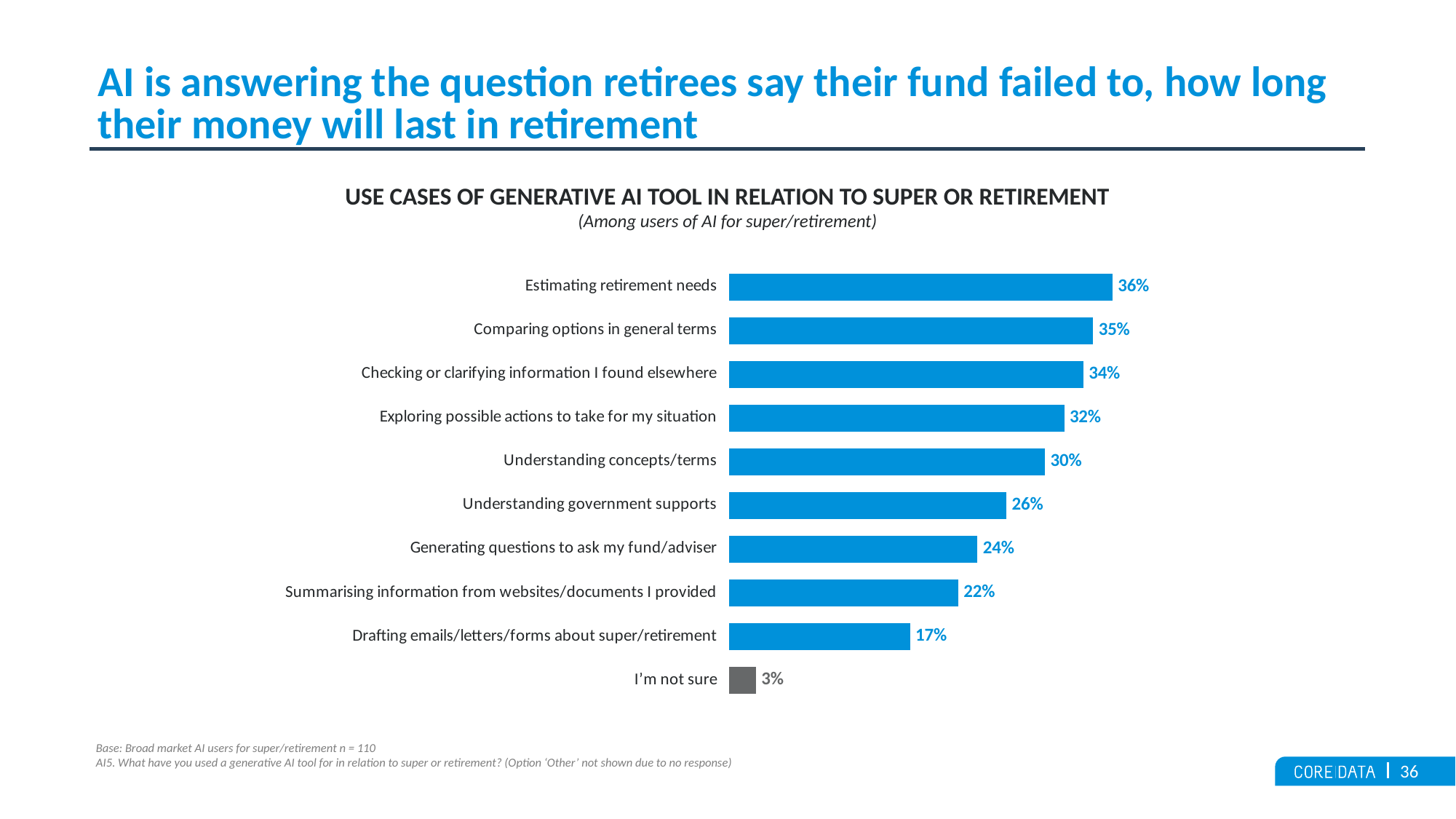
What is the difference between the highest and lowest values on the chart? 33 percentage points What percentage of users used a generative AI tool for estimating retirement needs? 36% How many categories are shown on the chart? 10 Which bar is shown in grey rather than blue? I'm not sure Which use case has the highest percentage? Estimating retirement needs What is the difference between 'Understanding concepts/terms' and 'Generating questions to ask my fund/adviser'? 6 percentage points Which is larger: 'Exploring possible actions to take for my situation' or 'Summarising information from websites/documents I provided'? Exploring possible actions to take for my situation Which category has the lowest value on the chart? I'm not sure What is the title of the chart? Use cases of generative AI tool in relation to super or retirement What is the value for 'Understanding government supports'? 26% What type of chart is shown on the slide? Bar chart What percentage is shown for 'Drafting emails/letters/forms about super/retirement'? 17%